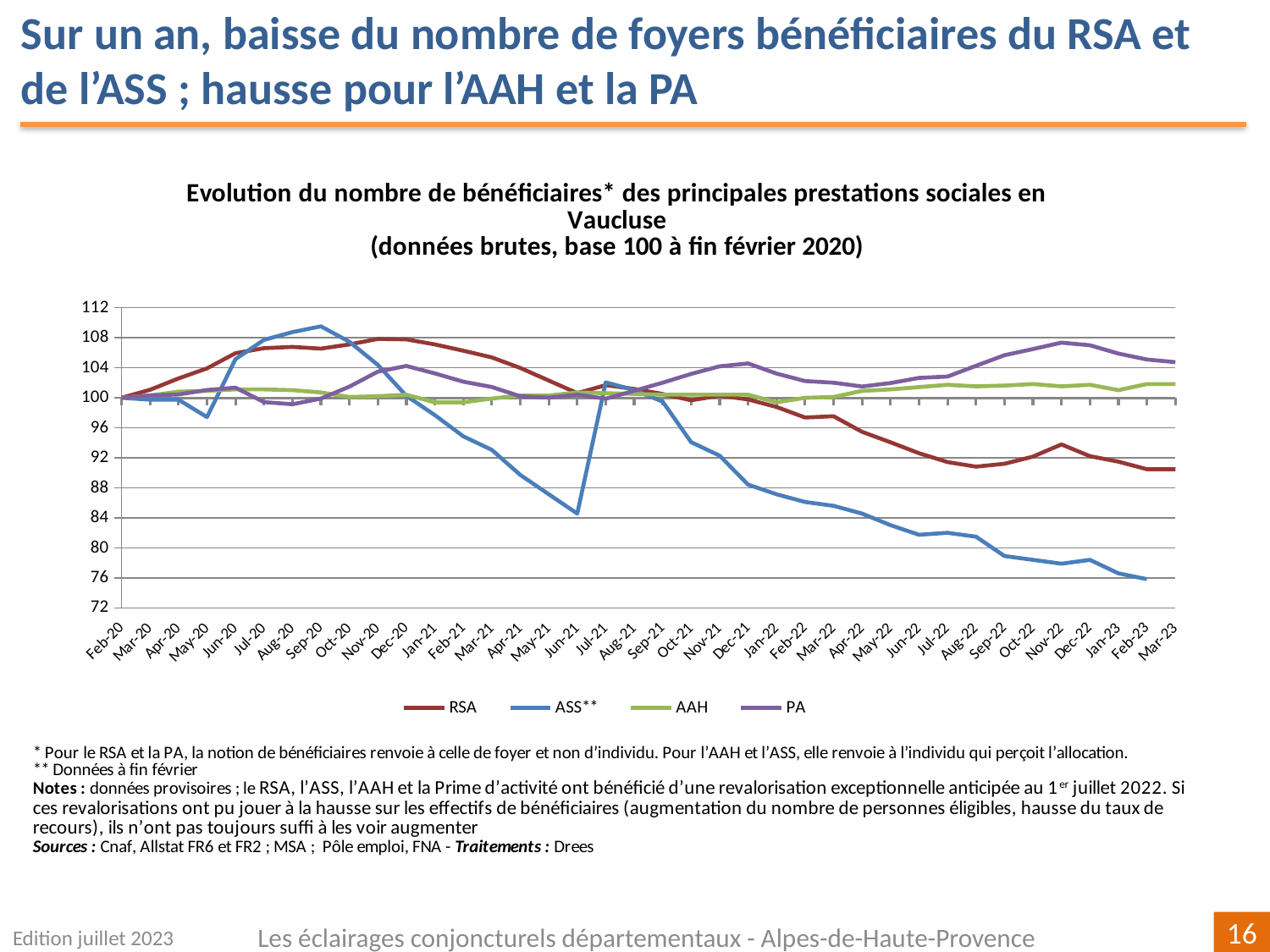
Which series has the highest value at Mar-23? PA At Mar-23, which is larger, the value for RSA or the value for AAH? AAH Which series has the highest value at Sep-20? ASS** Is the value for RSA at Mar-23 greater or less than 88? greater How many monthly points are shown on the x axis, from Feb-20 to Mar-23? 38 How many series does the legend list? 4 Does the ASS** series rise or fall between Sep-21 and Mar-23? fall Which series has the lowest value at Mar-23? RSA Is the value for PA at Nov-22 greater or less than 104? greater Which series is drawn in purple in the legend? PA What kind of chart is shown on the slide? line chart